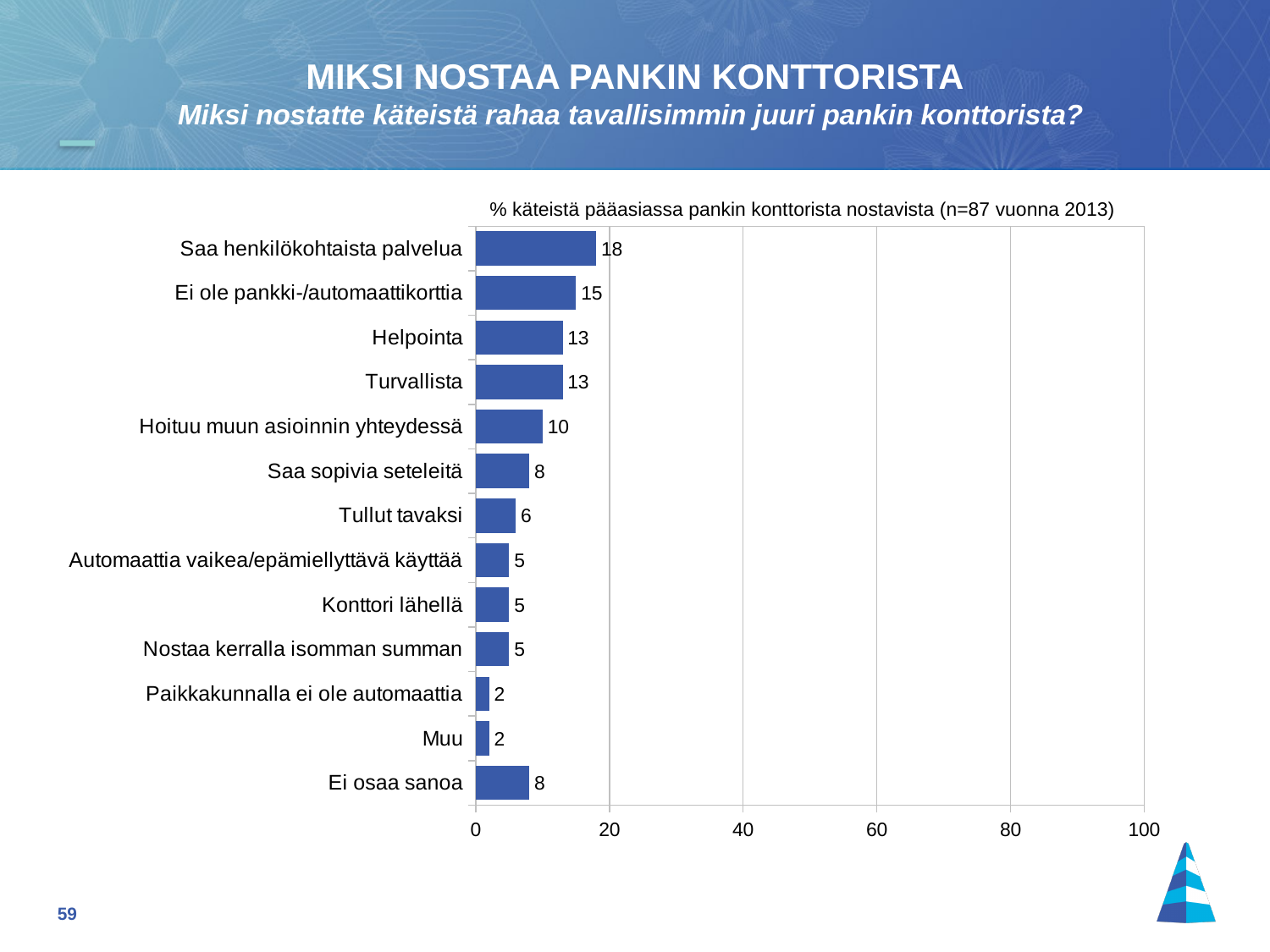
Is the value for "Saa henkilökohtaista palvelua" greater or less than 20? less What is the value for "Saa henkilökohtaista palvelua"? 18 What is the value for "Ei osaa sanoa"? 8 What is the sample size (n) stated in the chart's subtitle? n=87 Which is larger, the value for "Tullut tavaksi" or the value for "Saa sopivia seteleitä"? Saa sopivia seteleitä What is the difference between the values for "Saa henkilökohtaista palvelua" and "Ei ole pankki-/automaattikorttia"? 3 How many categories are shown in the chart? 13 What kind of chart is shown on the slide? bar chart What is the value for "Hoituu muun asioinnin yhteydessä"? 10 What is the value for "Muu"? 2 What is the difference between the values for "Helpointa" and "Tullut tavaksi"? 7 Which category has the highest value? Saa henkilökohtaista palvelua